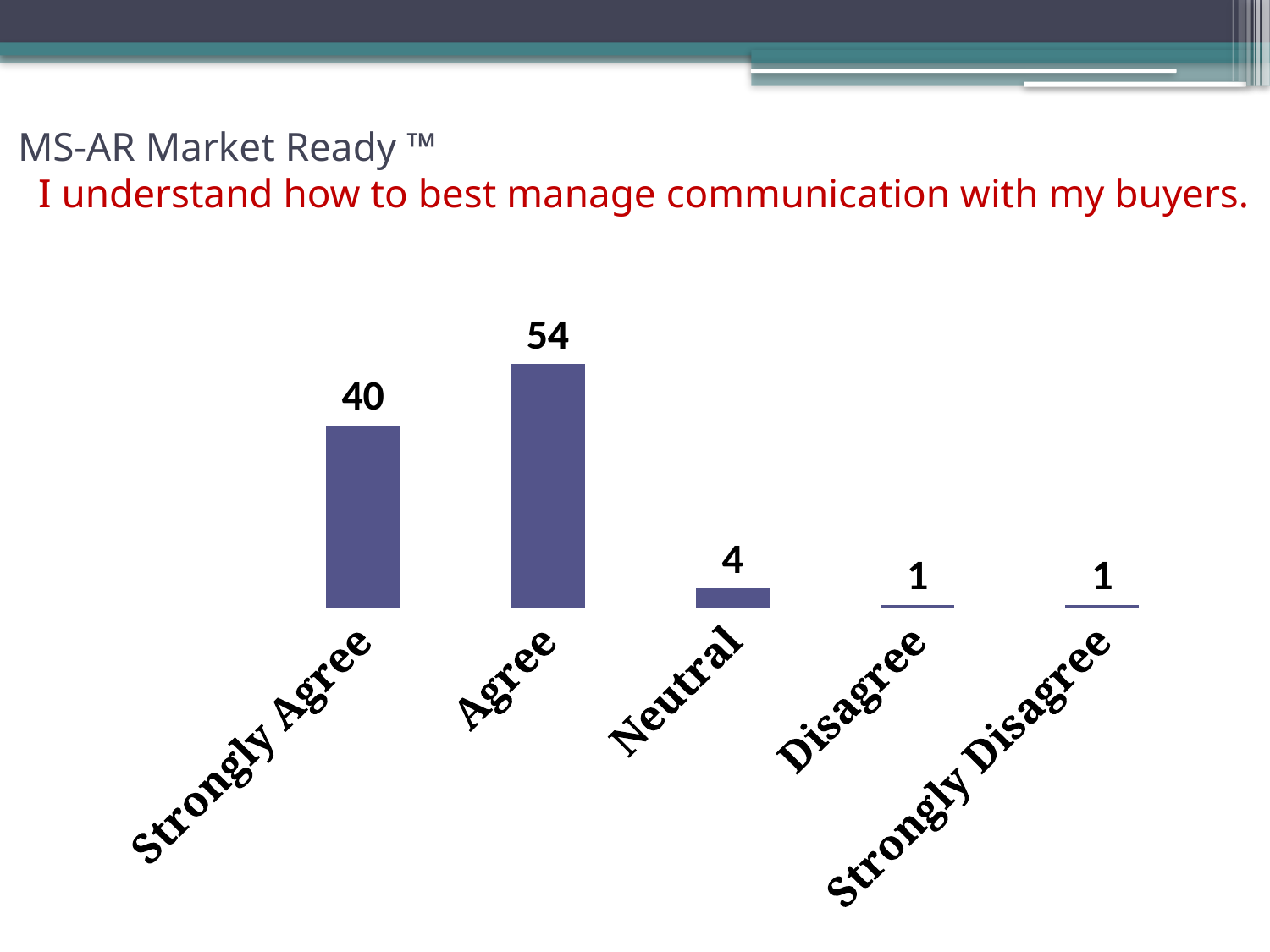
What is the value for Neutral? 4 What statement is the chart about, as shown in red text above it? I understand how to best manage communication with my buyers. What is the value for Agree? 54 What is the difference between the values for Agree and Strongly Agree? 14 What is the value for Disagree? 1 What is the value for Strongly Agree? 40 Which category has the highest value? Agree How many categories are shown on the x axis? 5 What kind of chart is shown on the slide? Bar chart What is the total of the values for Disagree and Strongly Disagree? 2 Which is larger, the value for Strongly Agree or the value for Neutral? Strongly Agree What is the difference between the values for Neutral and Disagree? 3